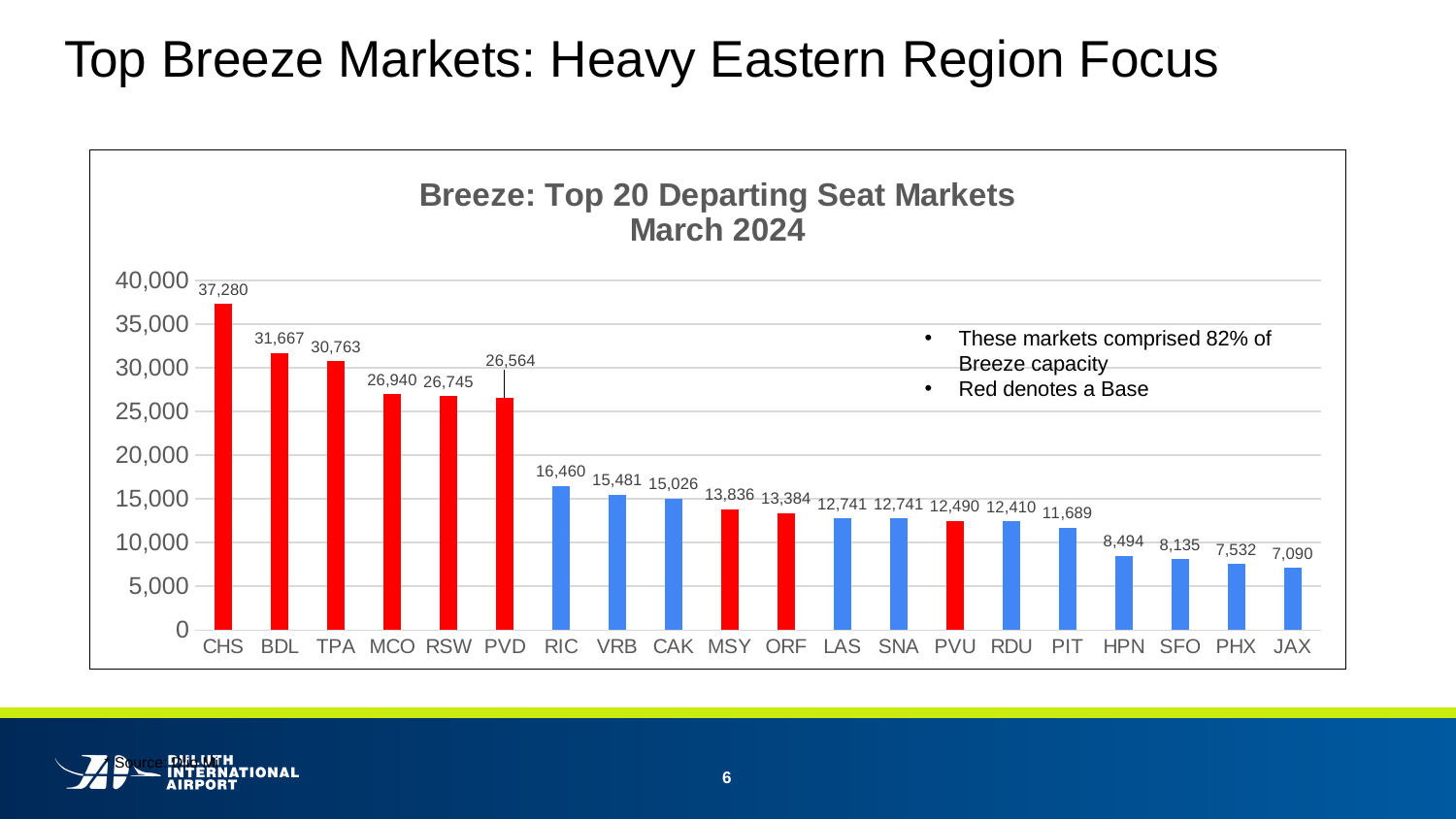
How many markets are shown on the chart? 20 Which is larger, the value for MSY or the value for ORF? MSY What is the difference between the values for CHS and BDL? 5,613 Which market has the highest number of departing seats? CHS Do the values rise or fall from left to right along the x axis? Fall What is the value for PVU? 12,490 What is the value for CHS? 37,280 What is the value for RIC? 16,460 Which market has the lowest number of departing seats? JAX According to the chart annotation, what does a red bar denote? A Base Is the value for PVD greater or less than 25,000? greater What kind of chart is this? Bar chart